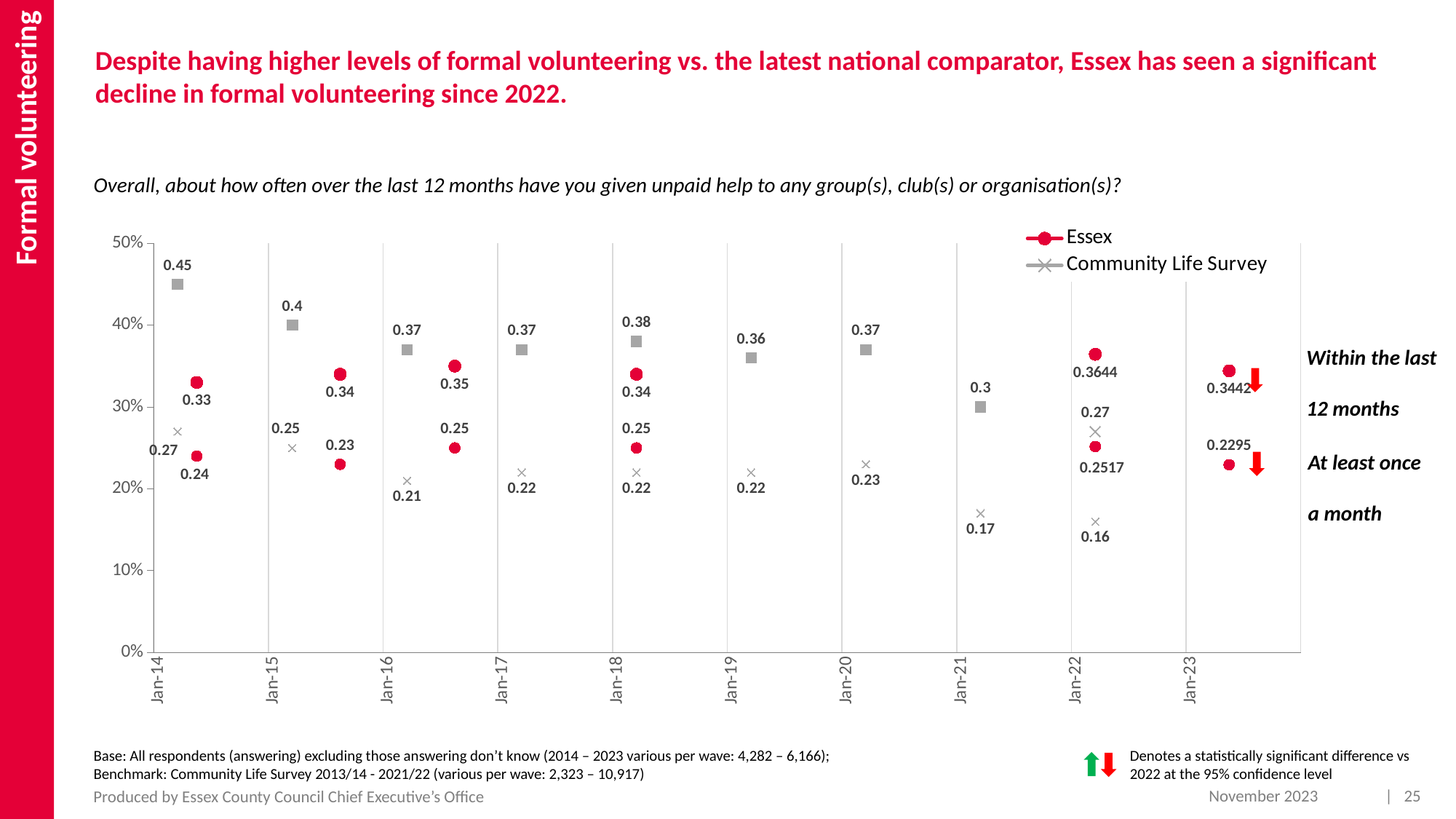
In which year is the Community Life Survey 'Within the last 12 months' value highest? Jan-14 What is the Essex value for 'At least once a month' at Jan-22? 0.2517 What is the difference between the Community Life Survey 'Within the last 12 months' values at Jan-14 and Jan-21? 0.15 What is the difference between the Essex 'Within the last 12 months' values at Jan-22 and Jan-23? 0.0202 Is the Community Life Survey 'At least once a month' value at Jan-22 greater or less than 20%? less What is the Community Life Survey value for 'At least once a month' at Jan-21? 0.17 At Jan-22, which is larger for 'Within the last 12 months': the Essex value or the Community Life Survey value? Essex What is the Essex value for 'Within the last 12 months' at Jan-23? 0.3442 What is the Community Life Survey value for 'Within the last 12 months' at Jan-14? 0.45 How many years are shown on the x axis? 10 In which year is the Community Life Survey 'At least once a month' value lowest? Jan-22 How many series does the legend list? 2